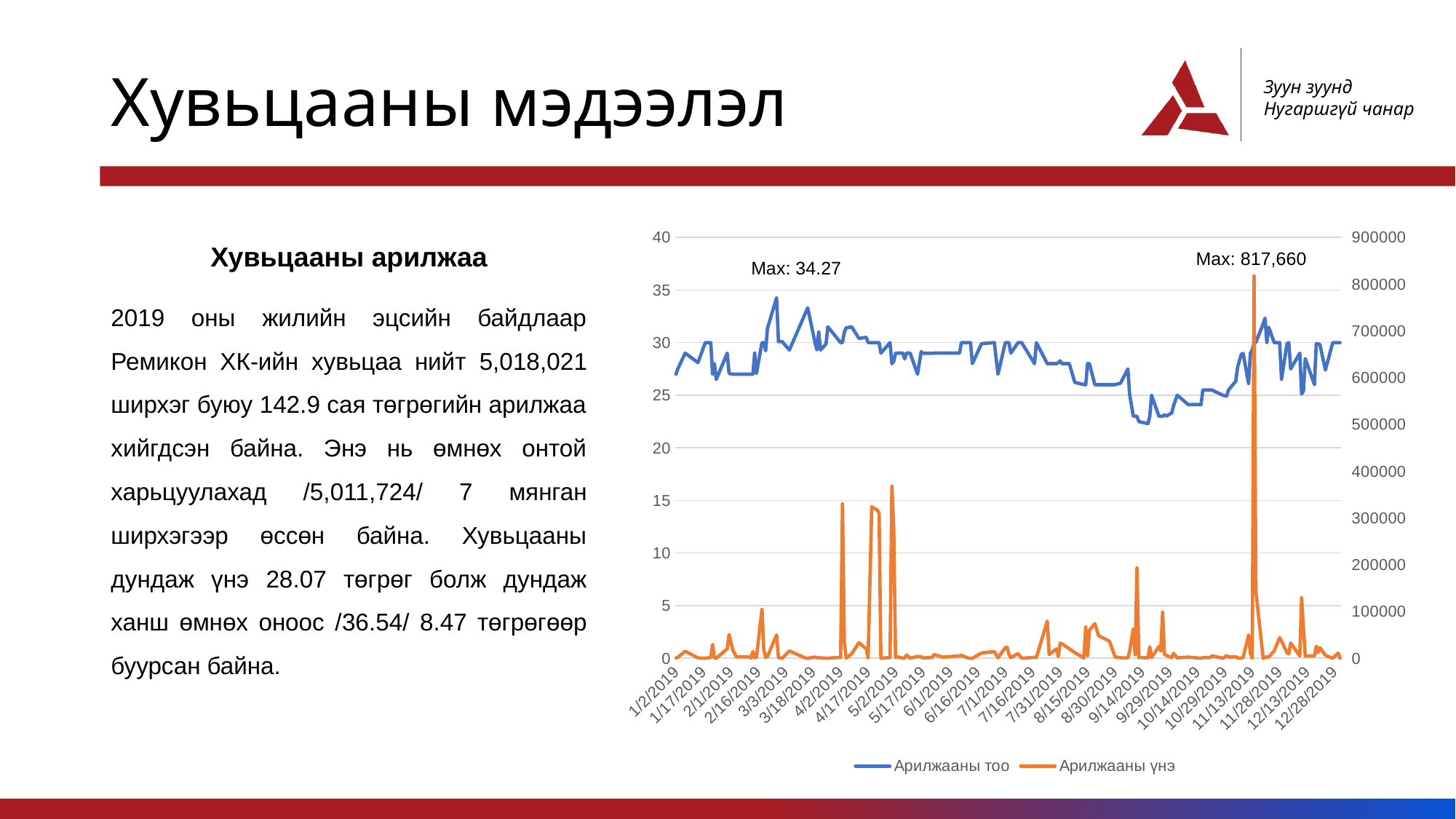
Does the blue line rise or fall between 7/16/2019 and 9/14/2019? fall What are the two series named in the chart legend? Арилжааны тоо and Арилжааны үнэ How many series does the chart legend list? 2 Is the blue line higher at 3/3/2019 or at 9/14/2019? 3/3/2019 Is the orange line at 6/1/2019 greater or less than 5 on the left axis? less Is the value of the blue line at 1/2/2019 greater or less than 25 on the left axis? greater What maximum value is annotated near the tall orange spike in the chart? 817,660 Is the value of the blue line at 9/14/2019 greater or less than 25 on the left axis? less What colour is the line for the series Арилжааны үнэ? orange What type of chart is shown on the slide? line chart What maximum value is annotated near the peak of the blue line in the chart? 34.27